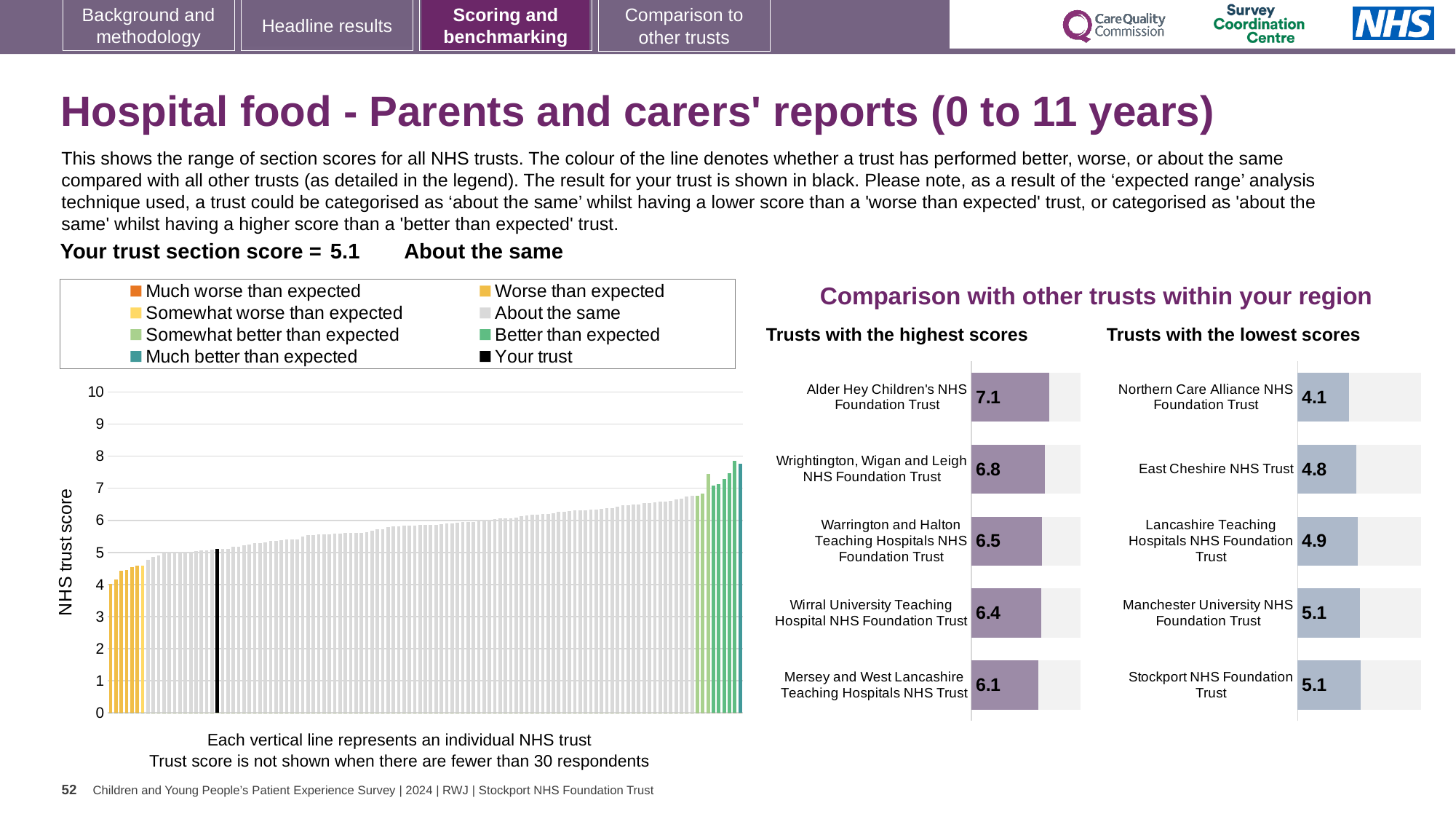
In the 'Trusts with the highest scores' chart, which trust has the highest score? Alder Hey Children's NHS Foundation Trust In the 'Trusts with the lowest scores' chart, which has the higher score: East Cheshire NHS Trust or Lancashire Teaching Hospitals NHS Foundation Trust? Lancashire Teaching Hospitals NHS Foundation Trust In the 'Trusts with the highest scores' chart, what is the score for Alder Hey Children's NHS Foundation Trust? 7.1 How many entries does the legend of the 'NHS trust score' chart on the left list? 8 In the 'Trusts with the lowest scores' chart, what is the score for Northern Care Alliance NHS Foundation Trust? 4.1 How many trusts are listed in the 'Trusts with the highest scores' chart? 5 In the 'Trusts with the lowest scores' chart, which trust has the lowest score? Northern Care Alliance NHS Foundation Trust In the 'Trusts with the highest scores' chart, what is the difference between the scores of Alder Hey Children's NHS Foundation Trust and Mersey and West Lancashire Teaching Hospitals NHS Trust? 1.0 In the 'Trusts with the highest scores' chart, what is the score for Wirral University Teaching Hospital NHS Foundation Trust? 6.4 What kind of chart is the 'NHS trust score' chart on the left of the slide? Bar chart In the 'Trusts with the lowest scores' chart, what is the score for Stockport NHS Foundation Trust? 5.1 In the 'NHS trust score' chart on the left, is the value of the tallest bar greater or less than 7? greater